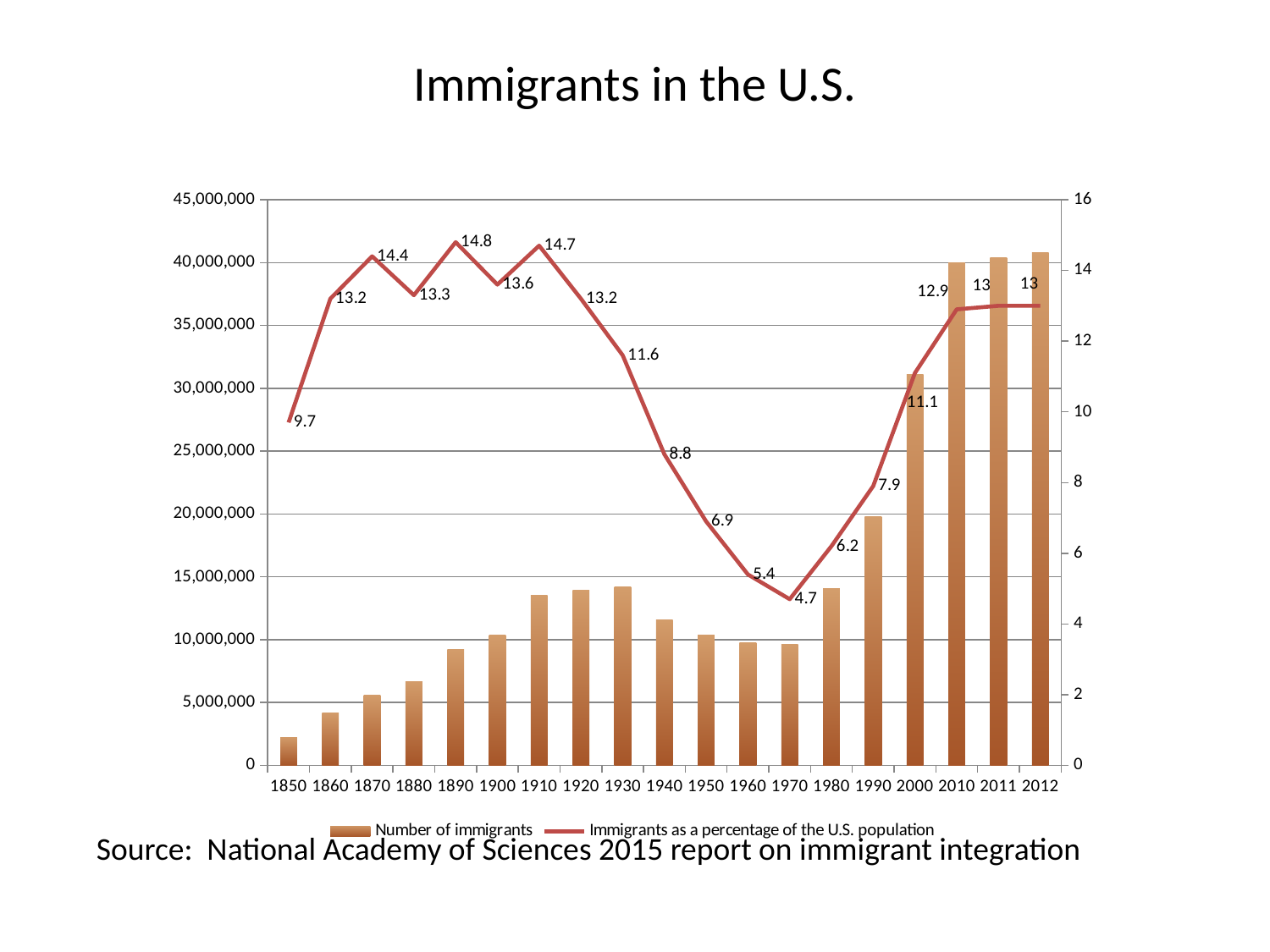
Is the number of immigrants in 2010 greater or less than 35,000,000? greater How many series does the legend list? 2 Which year had a higher immigrant percentage of the U.S. population, 1940 or 1990? 1940 What kind of chart is shown on the slide? Combination bar and line chart Is the number of immigrants in 1850 greater or less than 5,000,000? less What was the percentage of immigrants in the U.S. population in 1970? 4.7 What was the percentage of immigrants in the U.S. population in 2000? 11.1 In which year was the immigrant percentage of the U.S. population highest? 1890 In which year was the immigrant percentage of the U.S. population lowest? 1970 How many years are shown on the x axis? 19 What was the percentage of immigrants in the U.S. population in 1890? 14.8 What is the difference between the immigrant percentage in 1910 and in 1970? 10